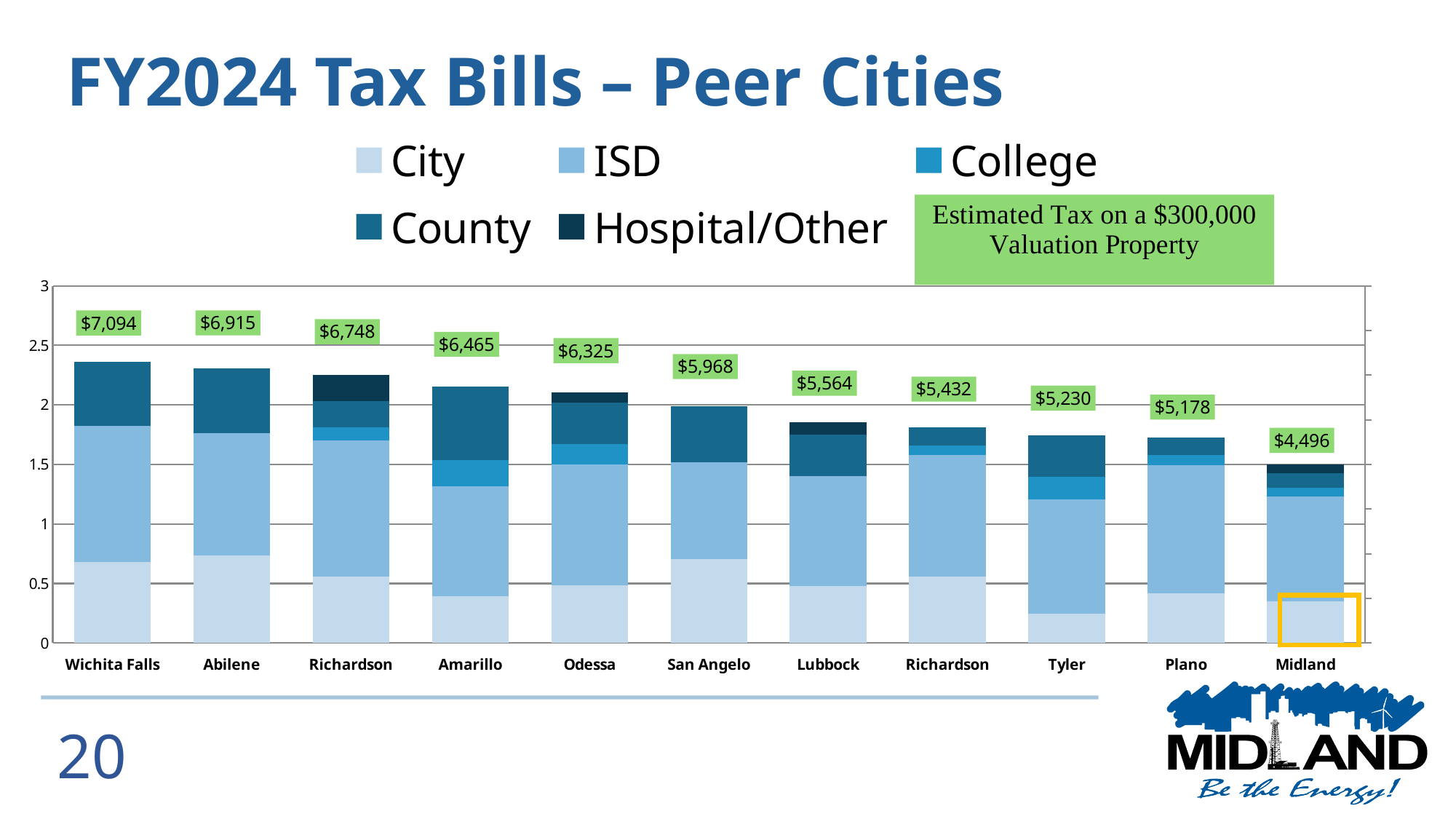
Do the labeled tax bills rise or fall from left to right across the cities? Fall What is the estimated tax bill labeled for Wichita Falls? $7,094 Which city has the lowest labeled tax bill? Midland What is the difference between the labeled tax bills for Wichita Falls and Midland? $2,598 How many series does the legend list? 5 How many city bars are shown on the chart? 11 What kind of chart is shown on the slide? Stacked bar chart Which city has the highest labeled tax bill? Wichita Falls What is the estimated tax bill labeled for Midland? $4,496 What is the estimated tax bill labeled for Lubbock? $5,564 Is the total height of the stacked bar for Midland greater or less than 2 on the y axis? less Which has a larger labeled tax bill, Odessa or San Angelo? Odessa